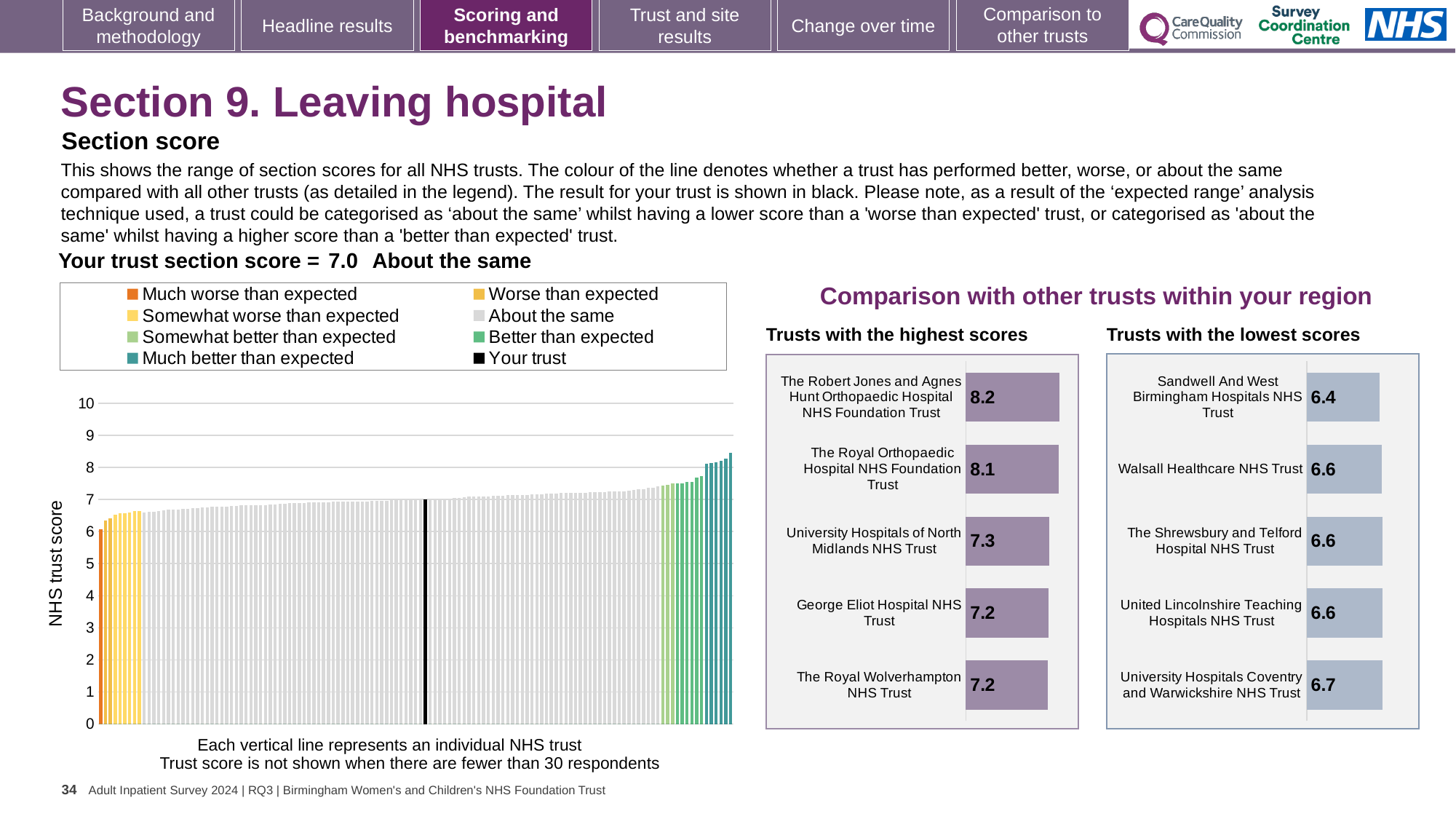
In the 'Trusts with the highest scores' chart, which has the higher score: University Hospitals of North Midlands NHS Trust or George Eliot Hospital NHS Trust? University Hospitals of North Midlands NHS Trust What kind of chart is the large 'NHS trust score' chart on the left of the slide? Bar chart In the 'Trusts with the lowest scores' chart, which trust has the lowest score? Sandwell And West Birmingham Hospitals NHS Trust In the 'NHS trust score' chart, what colour is used for the bar representing your trust? Black How many trusts are shown in the 'Trusts with the highest scores' chart? 5 How many entries does the legend of the 'NHS trust score' chart list? 8 In the 'Trusts with the lowest scores' chart, what is the score for Sandwell And West Birmingham Hospitals NHS Trust? 6.4 In the 'Trusts with the highest scores' chart, what is the score for The Robert Jones and Agnes Hunt Orthopaedic Hospital NHS Foundation Trust? 8.2 In the 'Trusts with the highest scores' chart, what is the difference between the scores of The Robert Jones and Agnes Hunt Orthopaedic Hospital NHS Foundation Trust and The Royal Orthopaedic Hospital NHS Foundation Trust? 0.1 In the 'Trusts with the highest scores' chart, which trust has the highest score? The Robert Jones and Agnes Hunt Orthopaedic Hospital NHS Foundation Trust In the 'Trusts with the lowest scores' chart, what is the difference between the scores of University Hospitals Coventry and Warwickshire NHS Trust and Sandwell And West Birmingham Hospitals NHS Trust? 0.3 According to the slide, what is your trust's section score for Section 9, Leaving hospital? 7.0